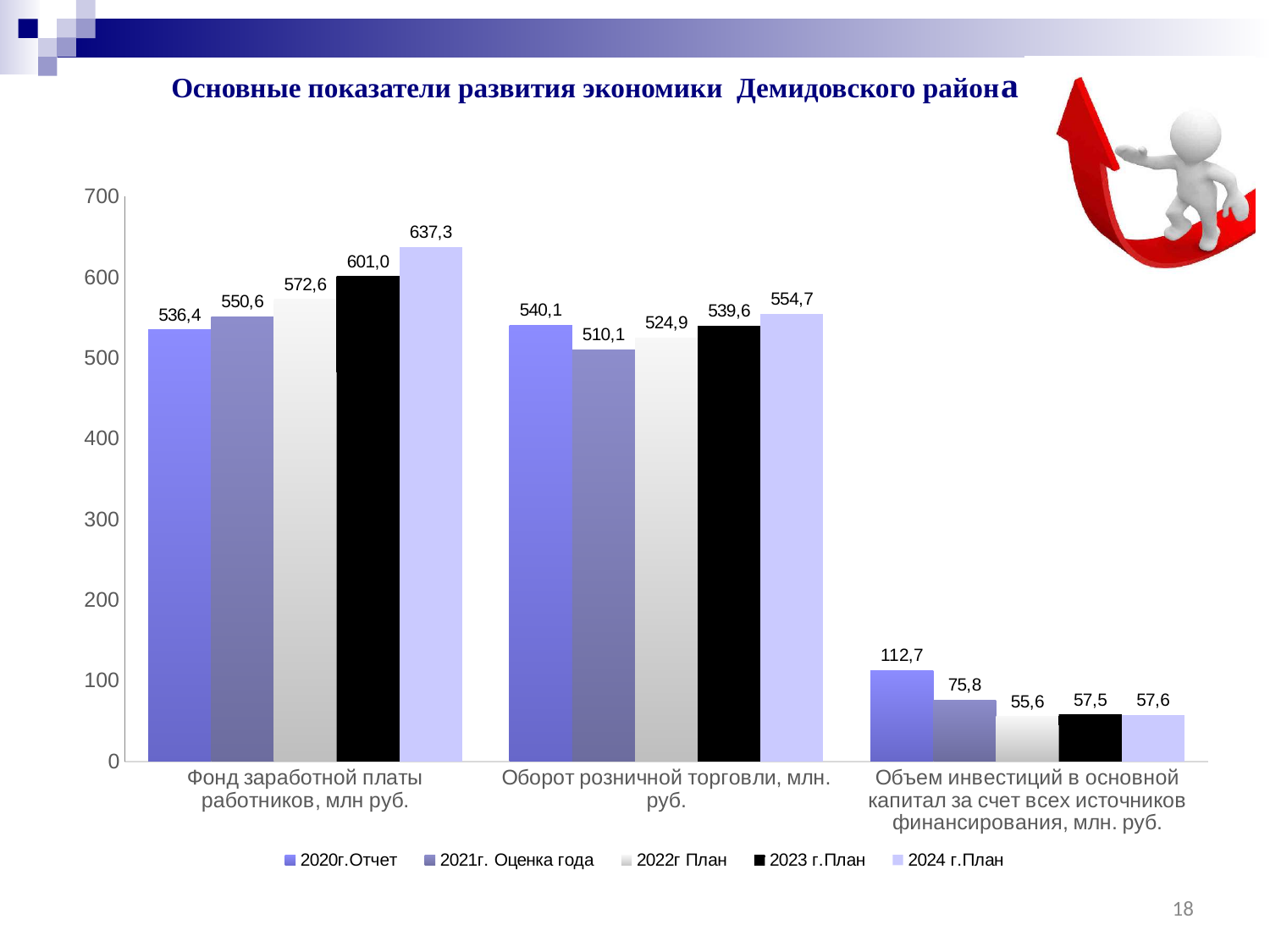
What kind of chart is shown on the slide? bar chart How many categories are shown on the x axis? 3 What is the value for 2021г. Оценка года in the category Оборот розничной торговли, млн. руб.? 510,1 Which series has the lowest value in the category Объем инвестиций в основной капитал за счет всех источников финансирования, млн. руб.? 2022г План What is the value for 2020г.Отчет in the category Объем инвестиций в основной капитал за счет всех источников финансирования, млн. руб.? 112,7 Is the 2020г.Отчет value for Объем инвестиций в основной капитал greater or less than 100? greater How many series does the legend list? 5 Which series has the highest value in the category Фонд заработной платы работников, млн руб.? 2024 г.План Which is larger: the 2023 г.План value for Фонд заработной платы работников or the 2023 г.План value for Оборот розничной торговли? Фонд заработной платы работников What is the difference between the 2024 г.План and 2020г.Отчет values for Фонд заработной платы работников, млн руб.? 100,9 What is the difference between the 2020г.Отчет and 2021г. Оценка года values for Объем инвестиций в основной капитал за счет всех источников финансирования, млн. руб.? 36,9 What is the value for 2024 г.План in the category Фонд заработной платы работников, млн руб.? 637,3